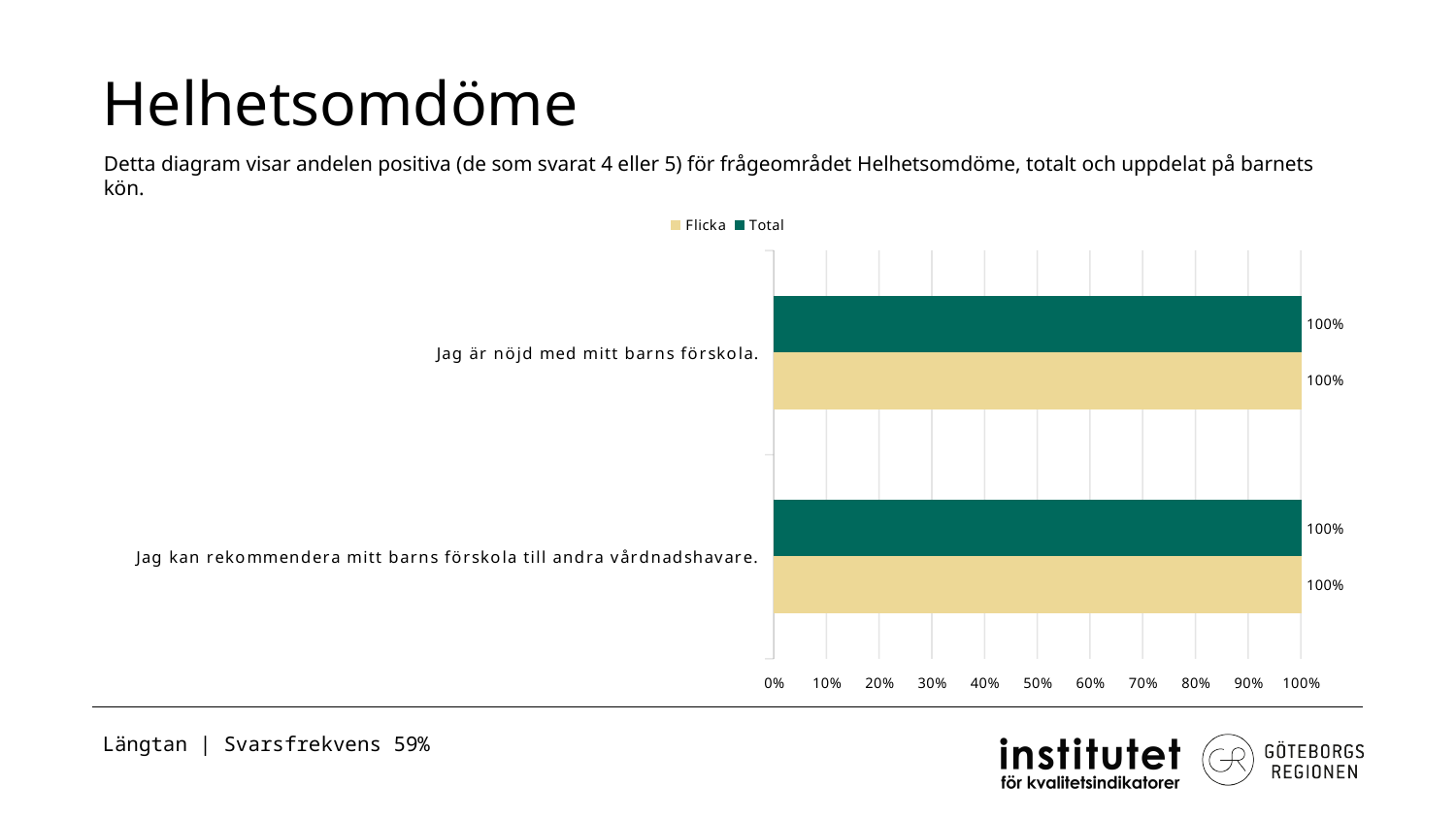
What is the highest value shown on the x axis? 100% What are the two series named in the legend? Flicka and Total Which series is shown in dark green? Total How many categories are plotted on the chart? 2 How many series does the legend list? 2 What is the Total value for "Jag är nöjd med mitt barns förskola."? 100% What is the difference between the Flicka and Total values for "Jag är nöjd med mitt barns förskola."? 0% What is the Total value for "Jag kan rekommendera mitt barns förskola till andra vårdnadshavare."? 100% Is the Total value for "Jag kan rekommendera mitt barns förskola till andra vårdnadshavare." greater or less than 90%? greater What is the Flicka value for "Jag kan rekommendera mitt barns förskola till andra vårdnadshavare."? 100% What kind of chart is shown on the slide? bar chart What is the Flicka value for "Jag är nöjd med mitt barns förskola."? 100%